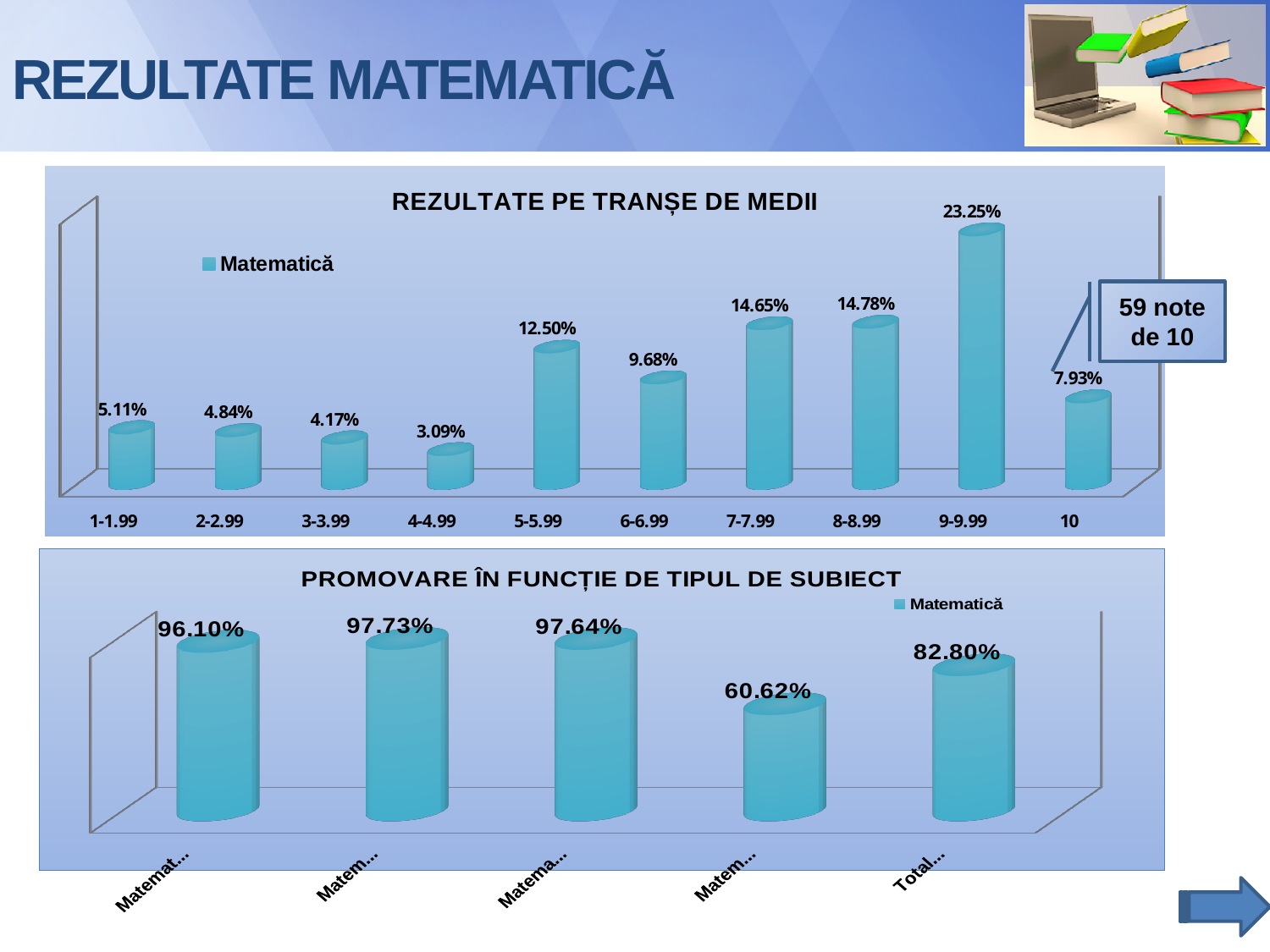
In the chart titled REZULTATE PE TRANȘE DE MEDII, what is the value for the 10 category? 7.93% In the chart titled PROMOVARE ÎN FUNCȚIE DE TIPUL DE SUBIECT, what is the lowest value shown? 60.62% How many series does the legend list in the chart titled REZULTATE PE TRANȘE DE MEDII? 1 In the chart titled REZULTATE PE TRANȘE DE MEDII, what is the value for the 9-9.99 category? 23.25% In the chart titled REZULTATE PE TRANȘE DE MEDII, how many categories are shown on the x axis? 10 What kind of chart is the chart titled PROMOVARE ÎN FUNCȚIE DE TIPUL DE SUBIECT? bar chart In the chart titled REZULTATE PE TRANȘE DE MEDII, what is the value for the 4-4.99 category? 3.09% In the chart titled REZULTATE PE TRANȘE DE MEDII, which category has the highest value? 9-9.99 In the chart titled REZULTATE PE TRANȘE DE MEDII, what is the difference between the values for 8-8.99 and 7-7.99? 0.13% In the chart titled REZULTATE PE TRANȘE DE MEDII, which is larger: the value for 5-5.99 or the value for 6-6.99? 5-5.99 In the chart titled PROMOVARE ÎN FUNCȚIE DE TIPUL DE SUBIECT, what is the value of the last (rightmost) bar? 82.80% In the chart titled REZULTATE PE TRANȘE DE MEDII, which category has the lowest value? 4-4.99